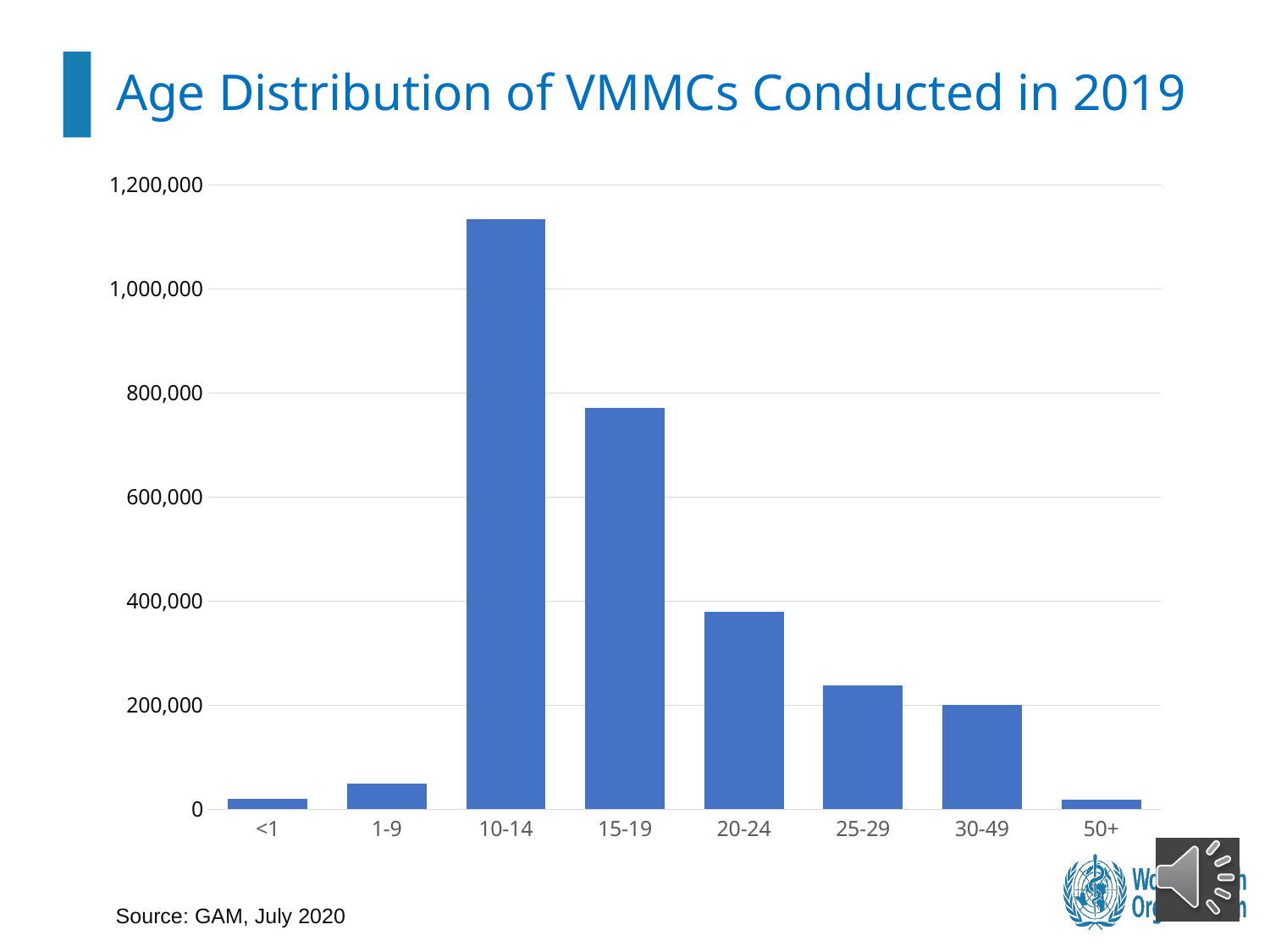
Is the value for the 20-24 age group greater or less than 400,000? less What kind of chart is shown on the slide? bar chart Is the value for the 15-19 age group greater or less than 800,000? less Which age group has the larger value, 1-9 or 25-29? 25-29 Which age group has the larger value, 15-19 or 20-24? 15-19 Is the value for the 1-9 age group greater or less than 200,000? less How many age groups are shown on the x axis? 8 What is the title of the chart? Age Distribution of VMMCs Conducted in 2019 From the 10-14 age group onward, do the values rise or fall as you move right along the x axis? fall Which age group has the highest number of VMMCs conducted in 2019? 10-14